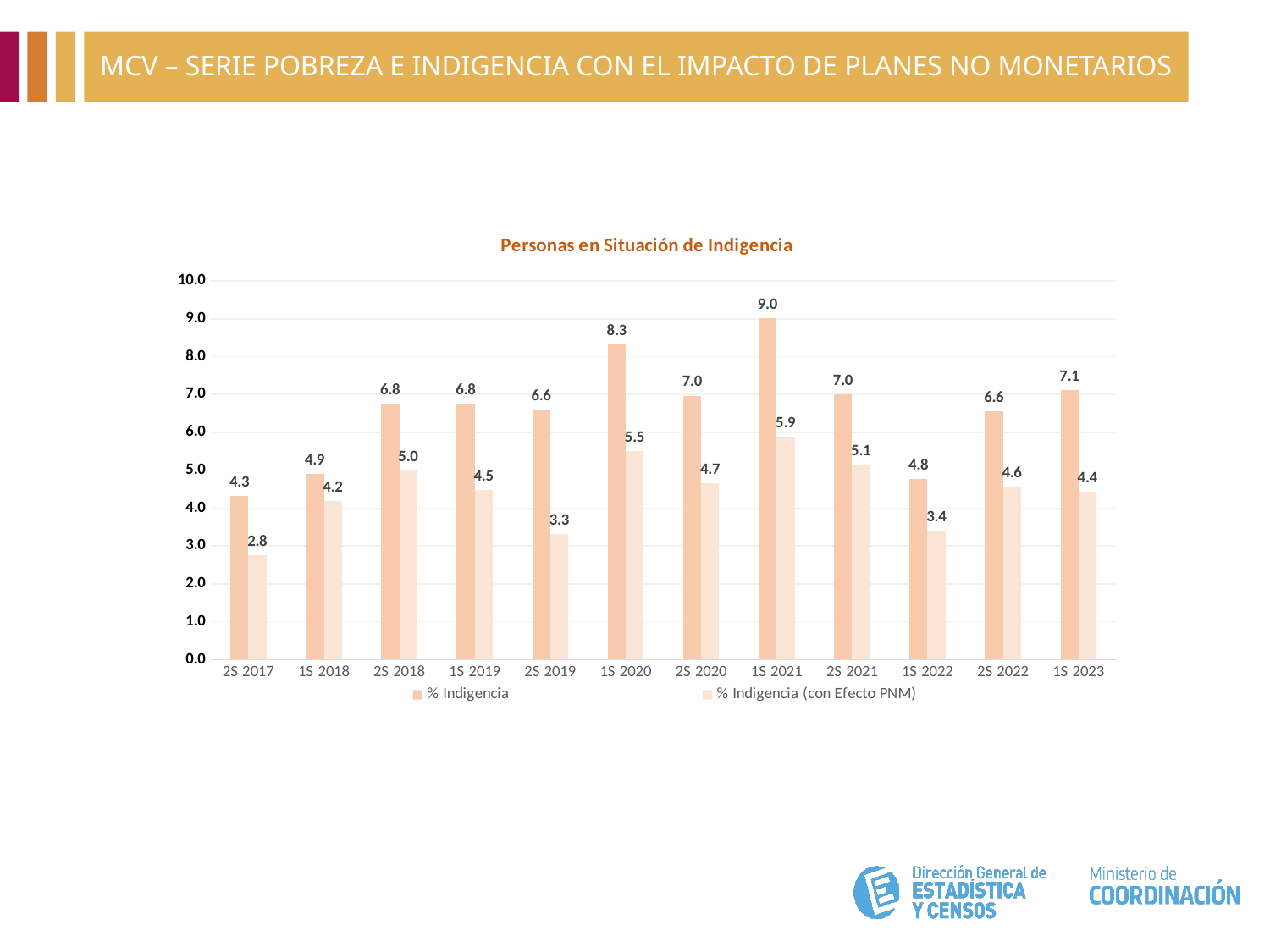
What is the value of % Indigencia (con Efecto PNM) for 1S 2023? 4.4 How many series does the legend list? 2 What is the difference between % Indigencia for 1S 2021 and for 2S 2021? 2.0 Which period has the highest value of % Indigencia? 1S 2021 What is the value of % Indigencia (con Efecto PNM) for 2S 2019? 3.3 What is the title of the chart? Personas en Situación de Indigencia What is the value of % Indigencia for 1S 2021? 9.0 Which is larger: % Indigencia (con Efecto PNM) for 1S 2020 or for 2S 2020? 1S 2020 What is the difference between % Indigencia and % Indigencia (con Efecto PNM) for 1S 2020? 2.8 What kind of chart is shown on the slide? Bar chart Which period has the lowest value of % Indigencia (con Efecto PNM)? 2S 2017 How many periods are shown on the x axis? 12